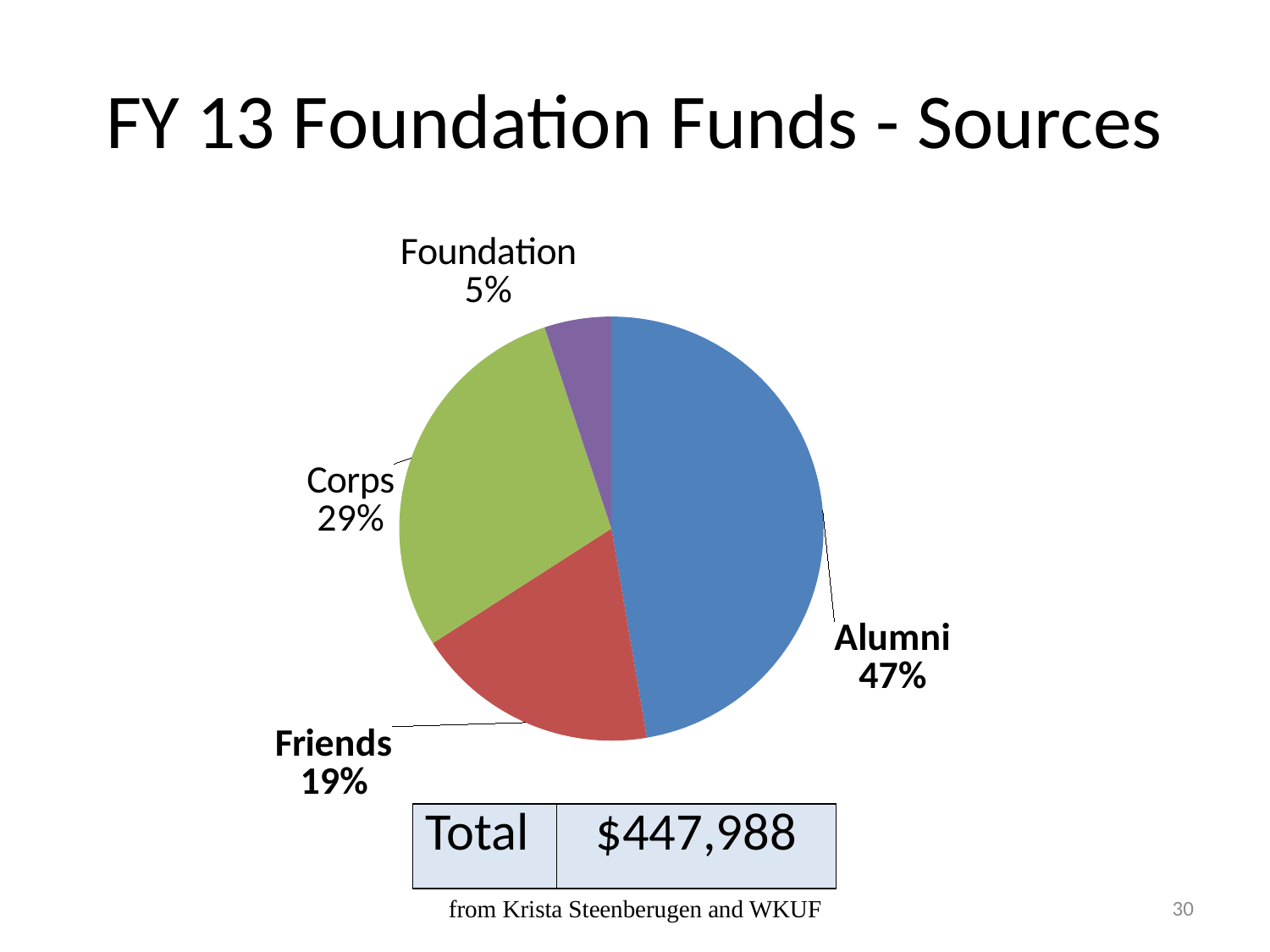
How many percentage points larger is the Alumni share than the Corps share? 18 What share of FY 13 Foundation Funds came from Alumni? 47% What share of FY 13 Foundation Funds came from Foundation? 5% What is the total amount of FY 13 Foundation Funds shown on the slide? $447,988 What kind of chart is shown on the slide? Pie chart How many sources are shown in the pie chart? 4 Which source accounts for the smallest share of FY 13 Foundation Funds? Foundation What share of FY 13 Foundation Funds came from Corps? 29% What colour is the Corps slice of the pie chart? Green Which source accounts for the largest share of FY 13 Foundation Funds? Alumni Which is larger, the Corps share or the Friends share? Corps What share of FY 13 Foundation Funds came from Friends? 19%